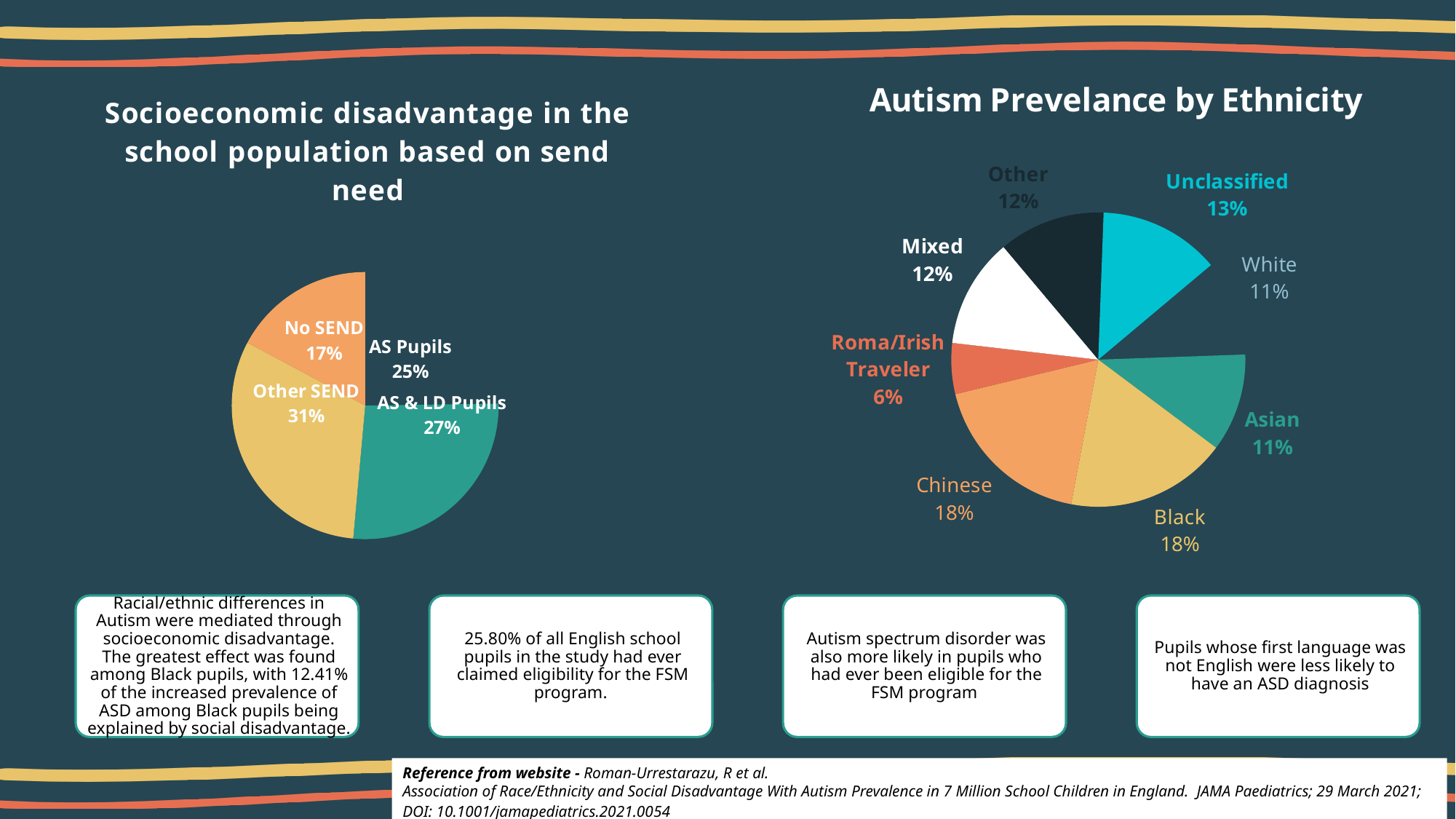
In the 'Autism Prevelance by Ethnicity' chart, which ethnicity has the smallest share? Roma/Irish Traveler In the 'Autism Prevelance by Ethnicity' chart, which is larger, the share for Chinese or the share for White? Chinese In the 'Socioeconomic disadvantage in the school population based on send need' chart, which category has the largest share? Other SEND In the 'Socioeconomic disadvantage in the school population based on send need' chart, what percentage is shown for Other SEND? 31% What type of chart is 'Autism Prevelance by Ethnicity'? Pie chart In the 'Socioeconomic disadvantage in the school population based on send need' chart, which category has the smallest share? No SEND How many ethnicity categories are shown in the 'Autism Prevelance by Ethnicity' chart? 8 How many categories are shown in the 'Socioeconomic disadvantage in the school population based on send need' chart? 4 In the 'Autism Prevelance by Ethnicity' chart, what percentage is shown for Unclassified? 13% In the 'Autism Prevelance by Ethnicity' chart, what percentage is shown for Roma/Irish Traveler? 6% In the 'Socioeconomic disadvantage in the school population based on send need' chart, what is the difference between the AS & LD Pupils and AS Pupils percentages? 2% In the 'Socioeconomic disadvantage in the school population based on send need' chart, what percentage is shown for AS & LD Pupils? 27%